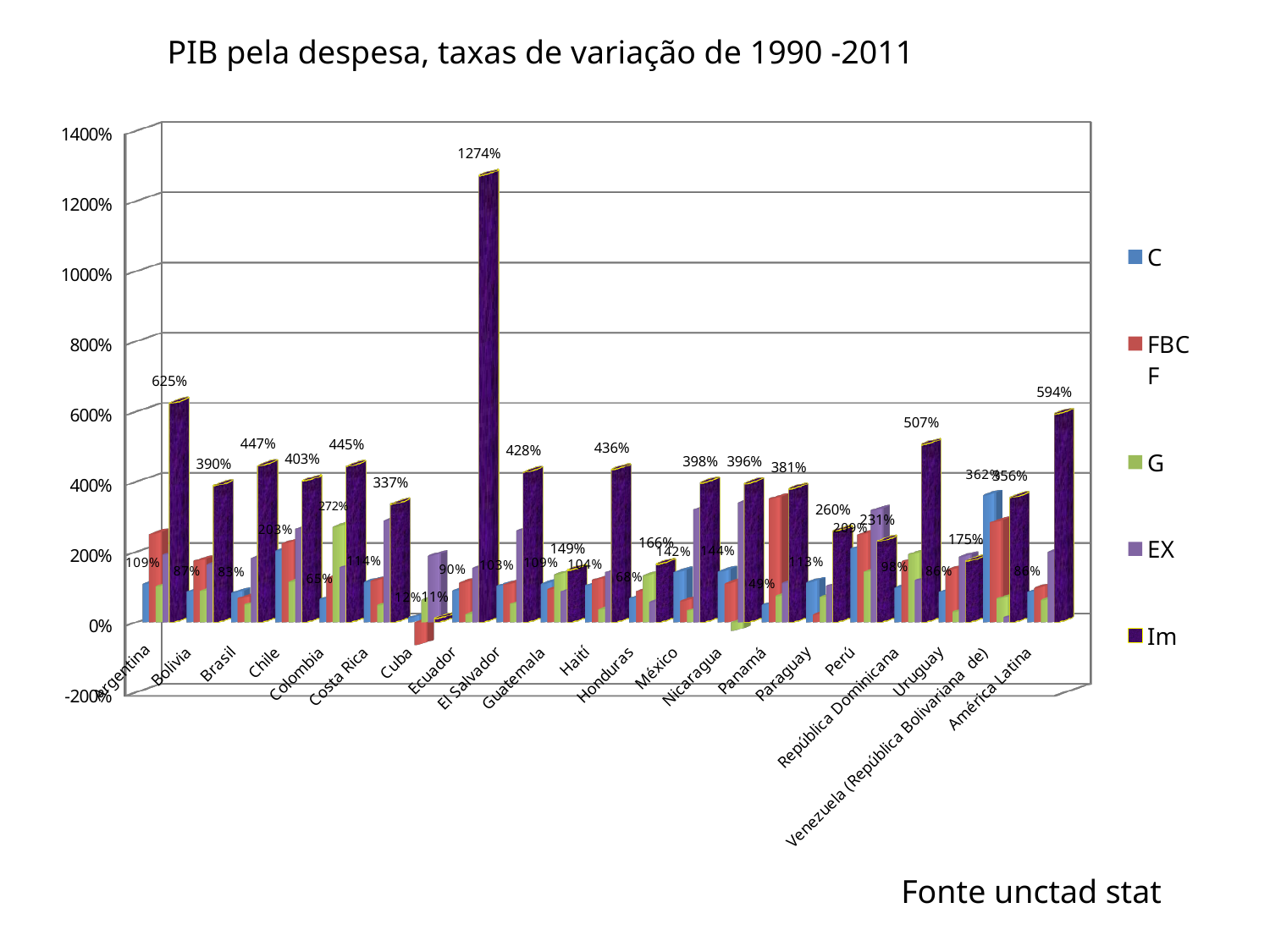
Is the Im value for Brasil greater or less than 400%? greater What is the title of the chart? PIB pela despesa, taxas de variação de 1990 -2011 How many series does the legend list? 5 What is the difference between the Im value for Argentina (625%) and the Im value for Bolivia (390%)? 235% Which is larger, the Im value for Argentina or the Im value for Bolivia? Argentina What kind of chart is shown on the slide? bar chart What is the Im value for Argentina? 625% Which series are listed in the legend? C, FBCF, G, EX, Im How many countries/regions are shown on the x axis? 21 Which category has the highest Im value? Ecuador What is the Im value for América Latina? 594% What is the Im value for Ecuador? 1274%